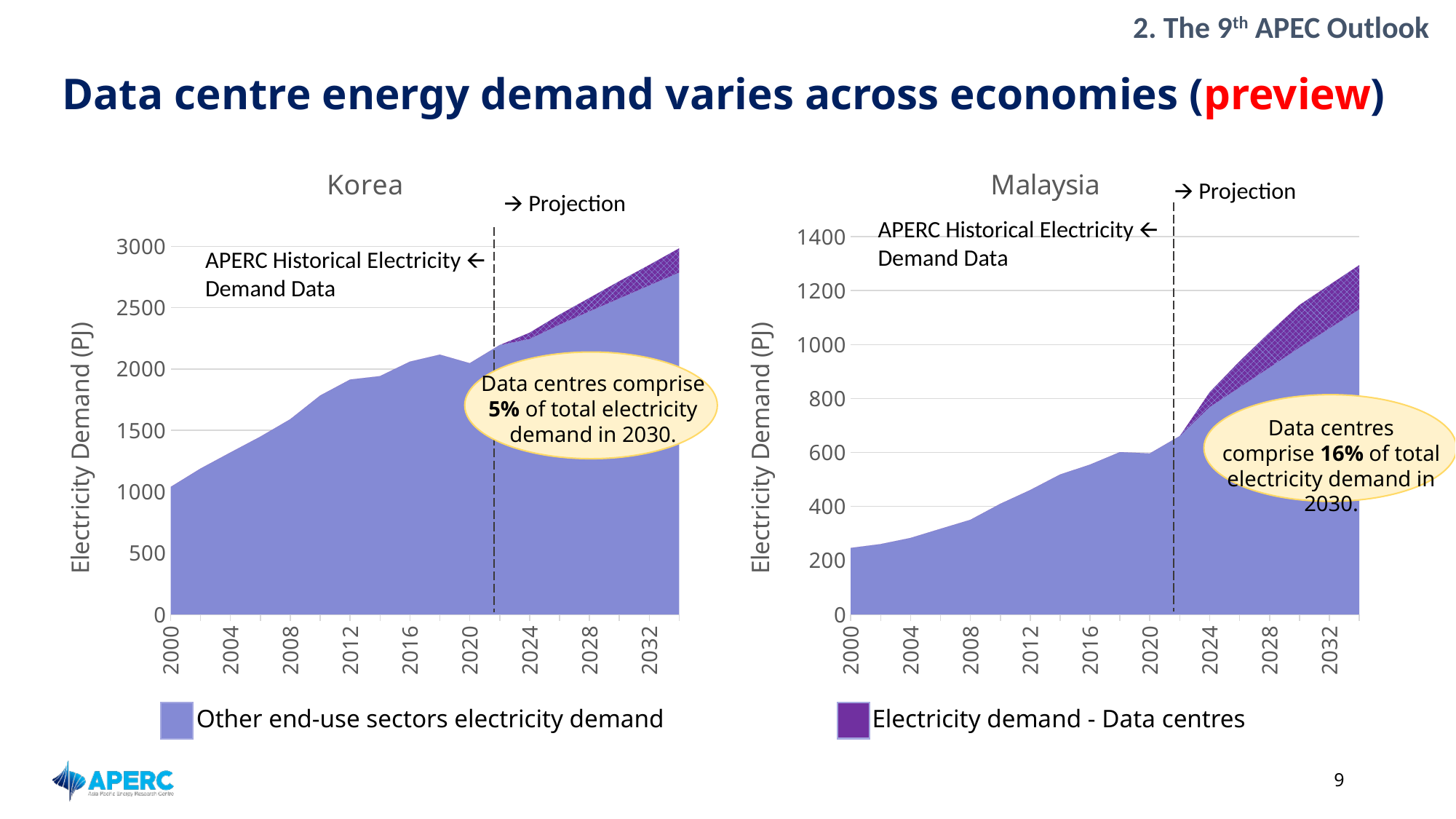
In the Korea chart, is the total electricity demand in 2000 greater or less than 1500? less In the Malaysia chart, what share of total electricity demand do data centres comprise in 2030? 16% In the Korea chart, what share of total electricity demand do data centres comprise in 2030? 5% In the Korea chart, which year has the larger total electricity demand, 2000 or 2032? 2032 What is the y-axis label on the Malaysia chart? Electricity Demand (PJ) In the Korea chart, is the total electricity demand in 2032 greater or less than 2500? greater What are the two series named in the legend? Other end-use sectors electricity demand; Electricity demand - Data centres In the Malaysia chart, is the total electricity demand in 2000 greater or less than 400? less In the Malaysia chart, does total electricity demand rise or fall from 2000 to 2032? rise How many series does the legend list for the charts? 2 What kind of chart is the Korea chart? Stacked area chart